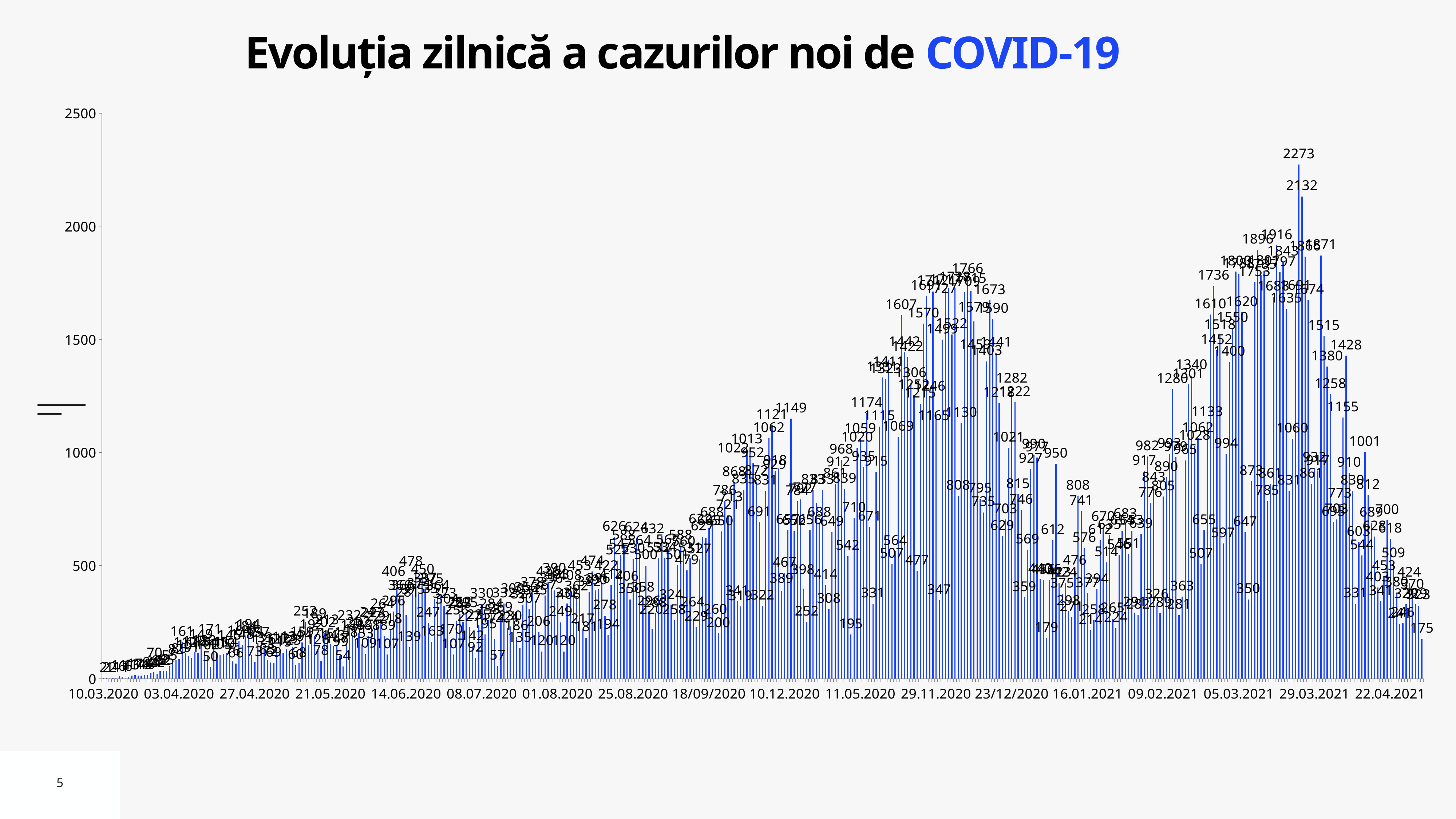
Which is larger, the peak value 2273 or the neighbouring value 2132? 2273 How many date labels are printed along the horizontal axis? 18 What is the first date label on the horizontal axis? 10.03.2020 What is the maximum value shown on the vertical axis? 2500 What is the last date label on the horizontal axis? 22.04.2021 What kind of chart is shown on the slide? bar chart What is the difference between the two highest labelled values, 2273 and 2132? 141 Is the highest bar on the chart greater or less than 2000? greater Do the values generally rise or fall between 10.03.2020 and 14.06.2020? rise What is the highest daily value labelled on the chart? 2273 What is the second-highest value labelled on the chart, next to the 2273 peak? 2132 What is the title of the chart? Evoluția zilnică a cazurilor noi de COVID-19